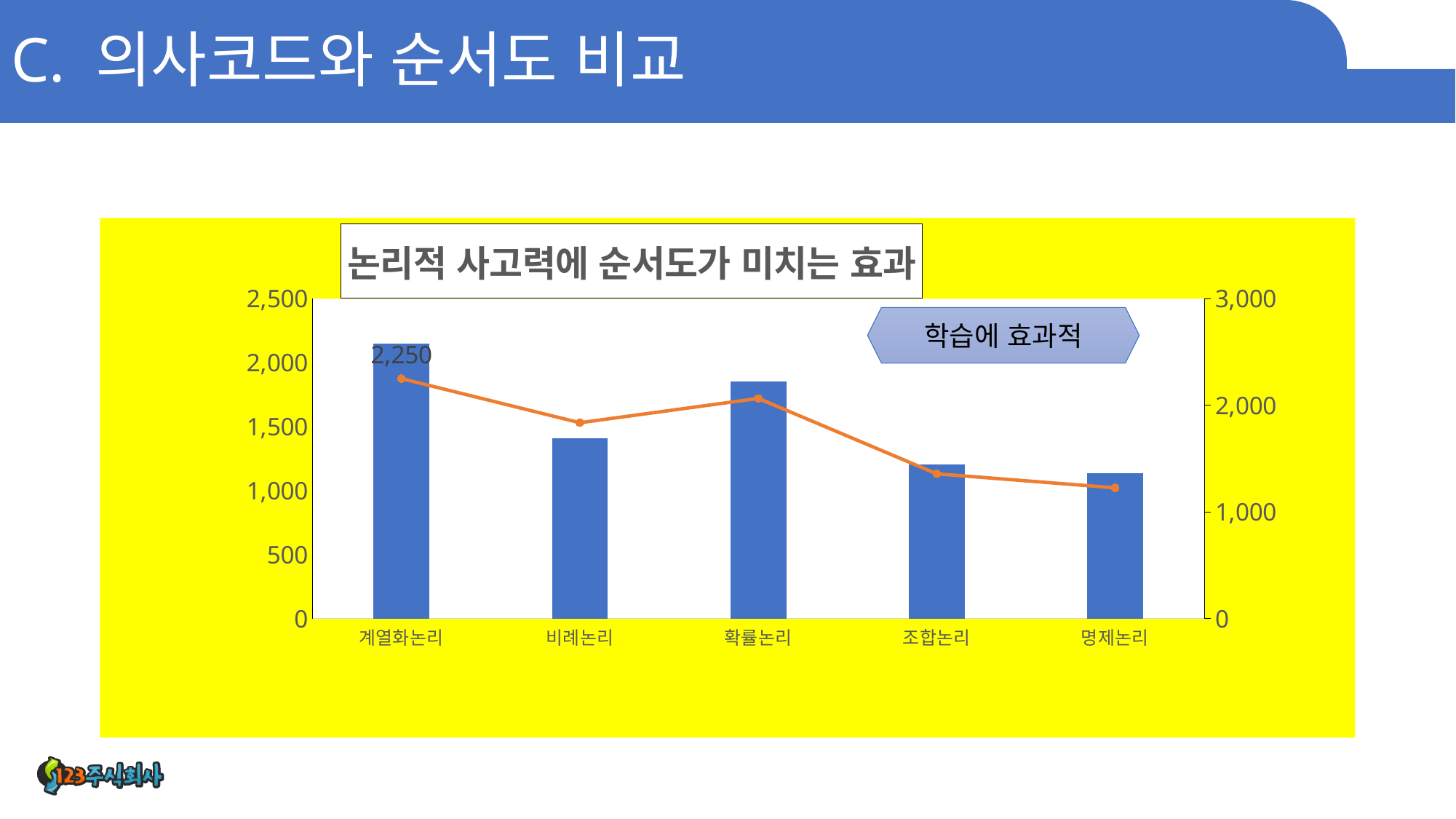
Which bar is taller, 확률논리 or 조합논리? 확률논리 Does the orange line generally rise or fall from left to right across the categories? fall What is the only data label printed on the chart? 2,250 How many categories are shown on the x axis of the chart? 5 What is the highest tick value shown on the right-hand axis of the chart? 3,000 What is the title of the chart? 논리적 사고력에 순서도가 미치는 효과 Is the bar for 명제논리 greater or less than 1,000 on the left axis? greater Which bar is taller, 계열화논리 or 비례논리? 계열화논리 Is the bar for 확률논리 greater or less than 1,500 on the left axis? greater Which category has the tallest bar in the chart? 계열화논리 Is the bar for 비례논리 greater or less than 1,500 on the left axis? less What kind of chart is shown on the slide? A bar chart combined with a line